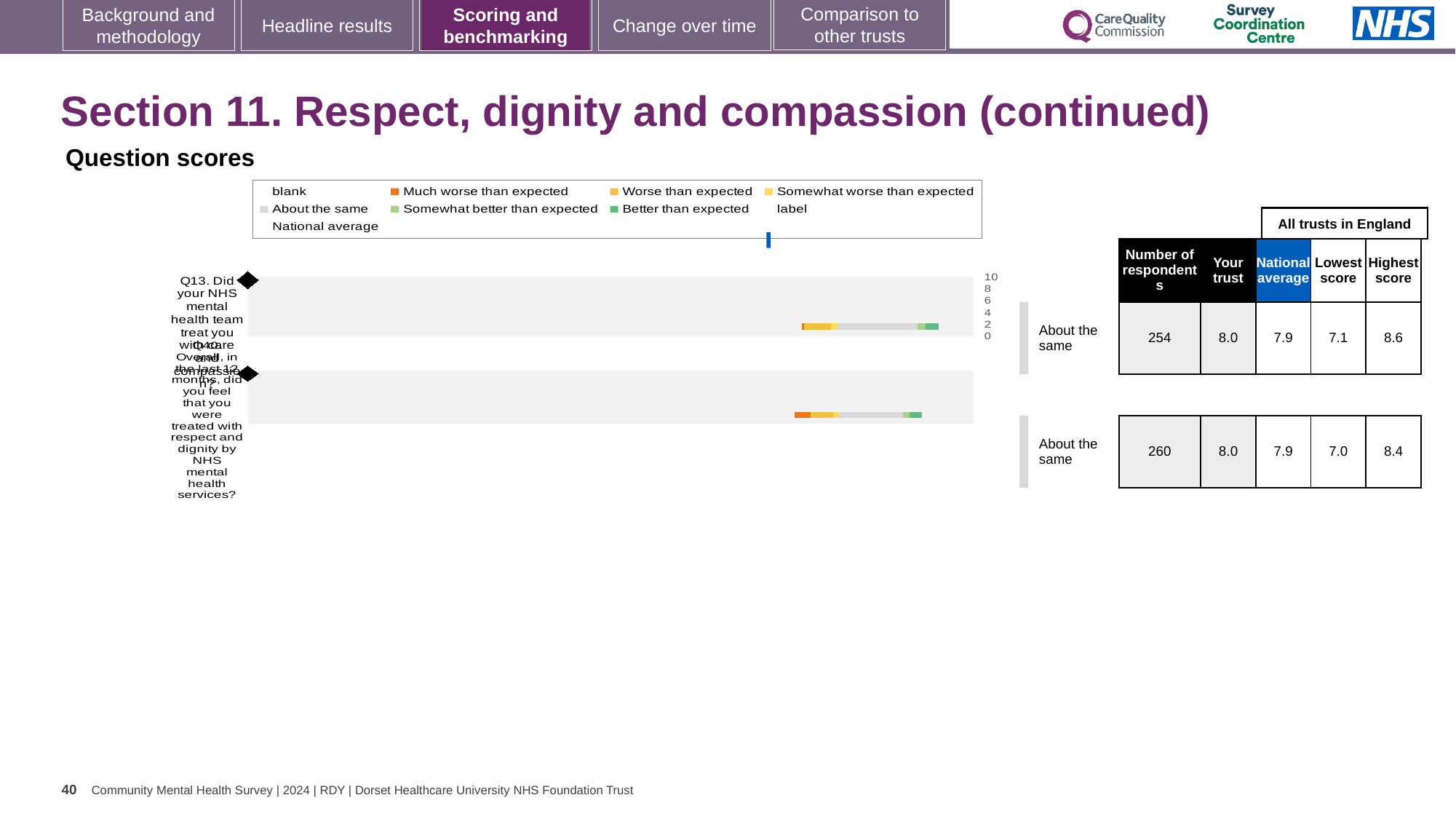
Which question has more respondents, Q13 or Q14? Q14 What is the number of respondents for Q13? 254 What is the highest score among all trusts in England for Q14? 8.4 What is the national average score for Q13? 7.9 What kind of chart is shown on the slide? Bar chart What benchmark category is shown for Q14? About the same What is the 'Your trust' score for Q14? 8.0 What colour does the legend use for 'Much worse than expected'? Orange What is the lowest score among all trusts in England for Q13? 7.1 For Q13, is the 'Your trust' score higher or lower than the national average? Higher What is the difference between the highest score and the lowest score for Q13? 1.5 How many survey questions are plotted in the chart? 2